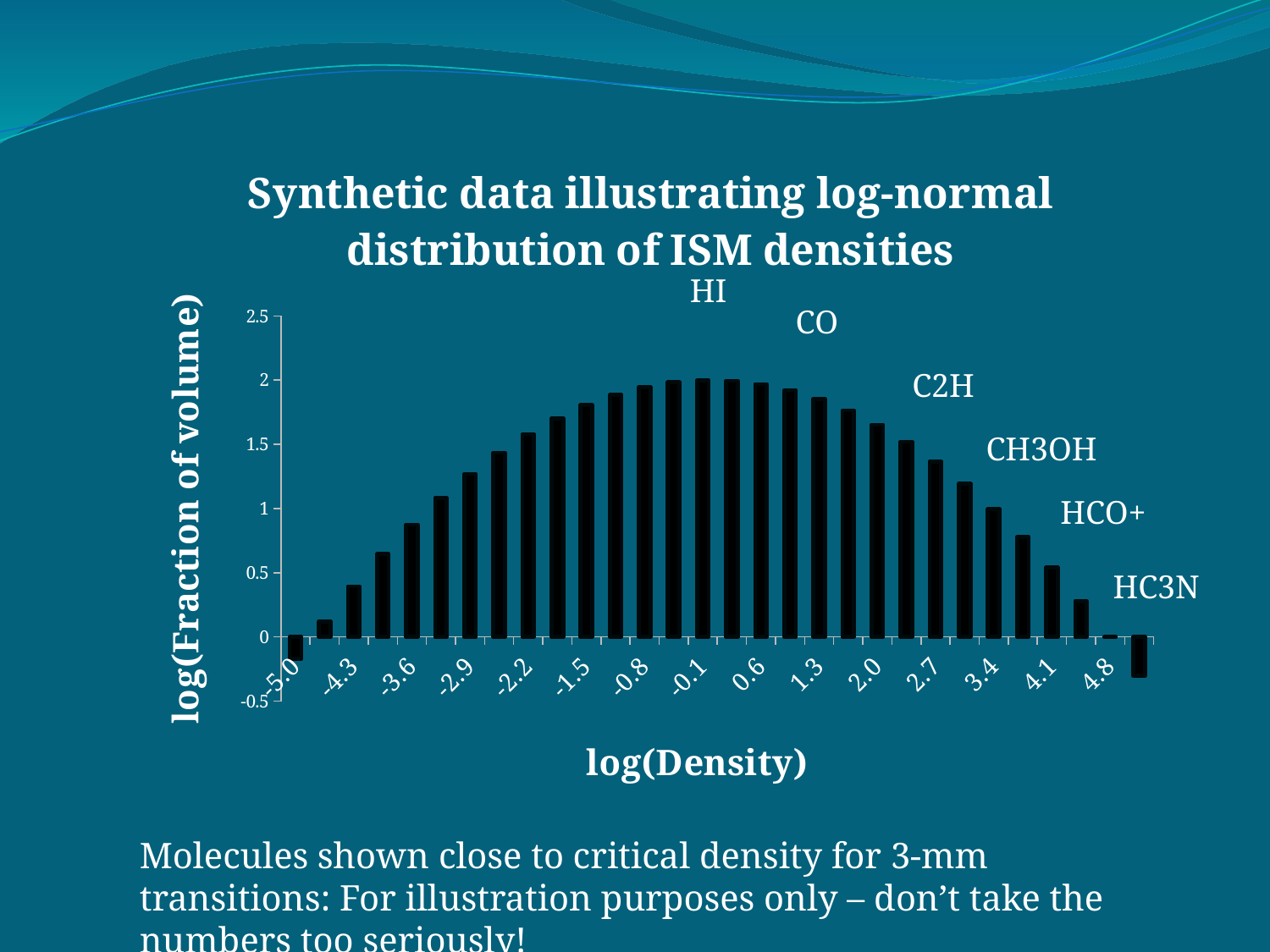
Is the value for log(Density) = 2.0 greater or less than 1.5? greater Is the value for log(Density) = -2.2 greater or less than 1.5? greater What is the label of the x axis? log(Density) Is the value for log(Density) = -3.6 greater or less than 1? less What kind of chart is shown on the slide? bar chart Which is larger, the value at log(Density) = -3.6 or the value at log(Density) = 2.0? 2.0 What is the title of the chart? Synthetic data illustrating log-normal distribution of ISM densities Do the values rise or fall along the x axis from log(Density) = 0.6 to 4.8? fall Do the values rise or fall along the x axis from log(Density) = -5.0 to -0.1? rise